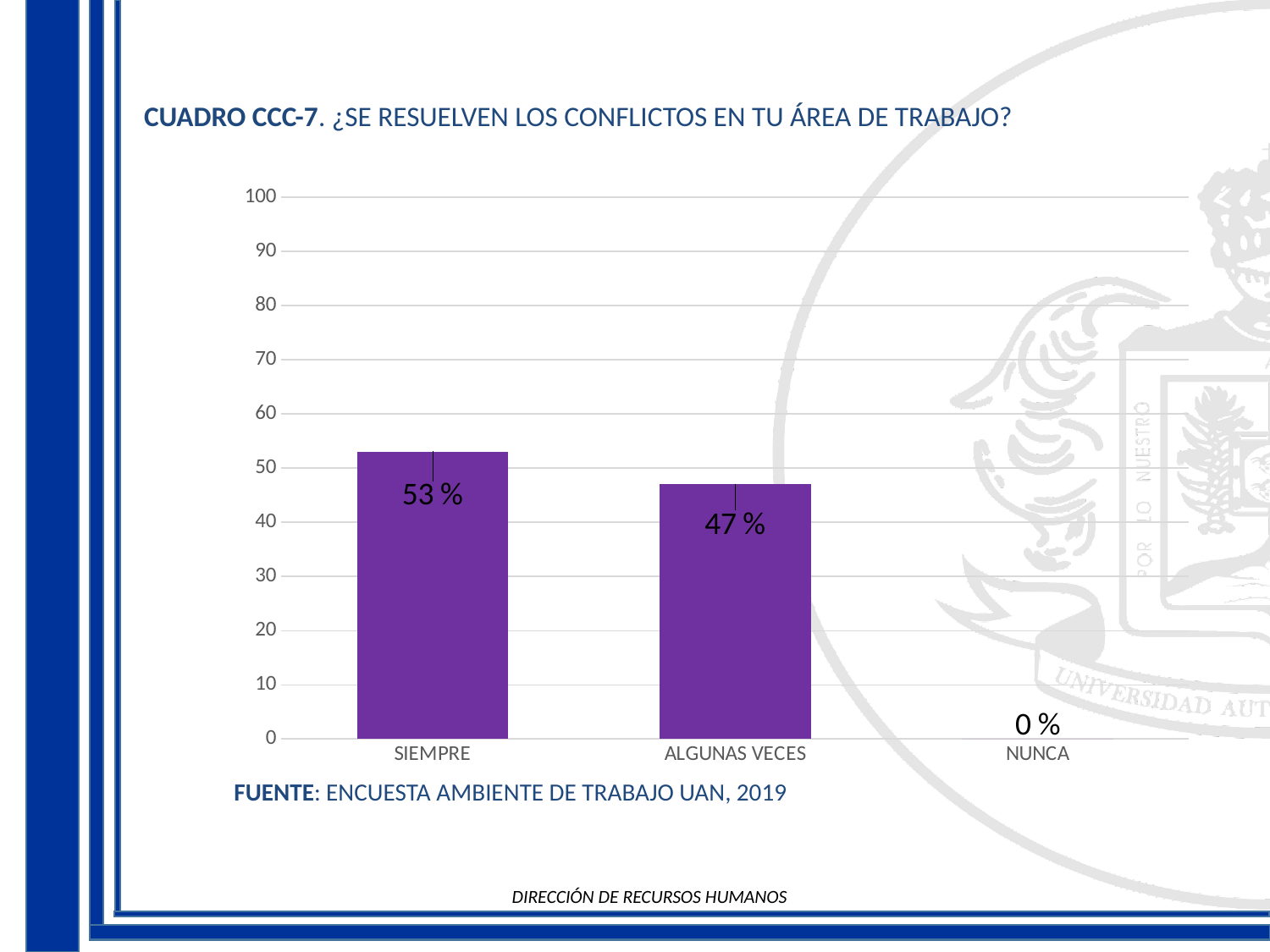
Which is larger, the value for SIEMPRE or the value for ALGUNAS VECES? SIEMPRE How many categories are shown on the x axis? 3 Is the value for ALGUNAS VECES greater or less than 50? less What is the value for NUNCA? 0 % Which category has the highest value? SIEMPRE Do the values rise or fall from left to right along the x axis? fall What is the difference between the values for SIEMPRE and ALGUNAS VECES? 6 % What is the value for SIEMPRE? 53 % What is the value for ALGUNAS VECES? 47 % Which category has the lowest value? NUNCA What kind of chart is shown on the slide? bar chart What is the source cited below the chart? ENCUESTA AMBIENTE DE TRABAJO UAN, 2019